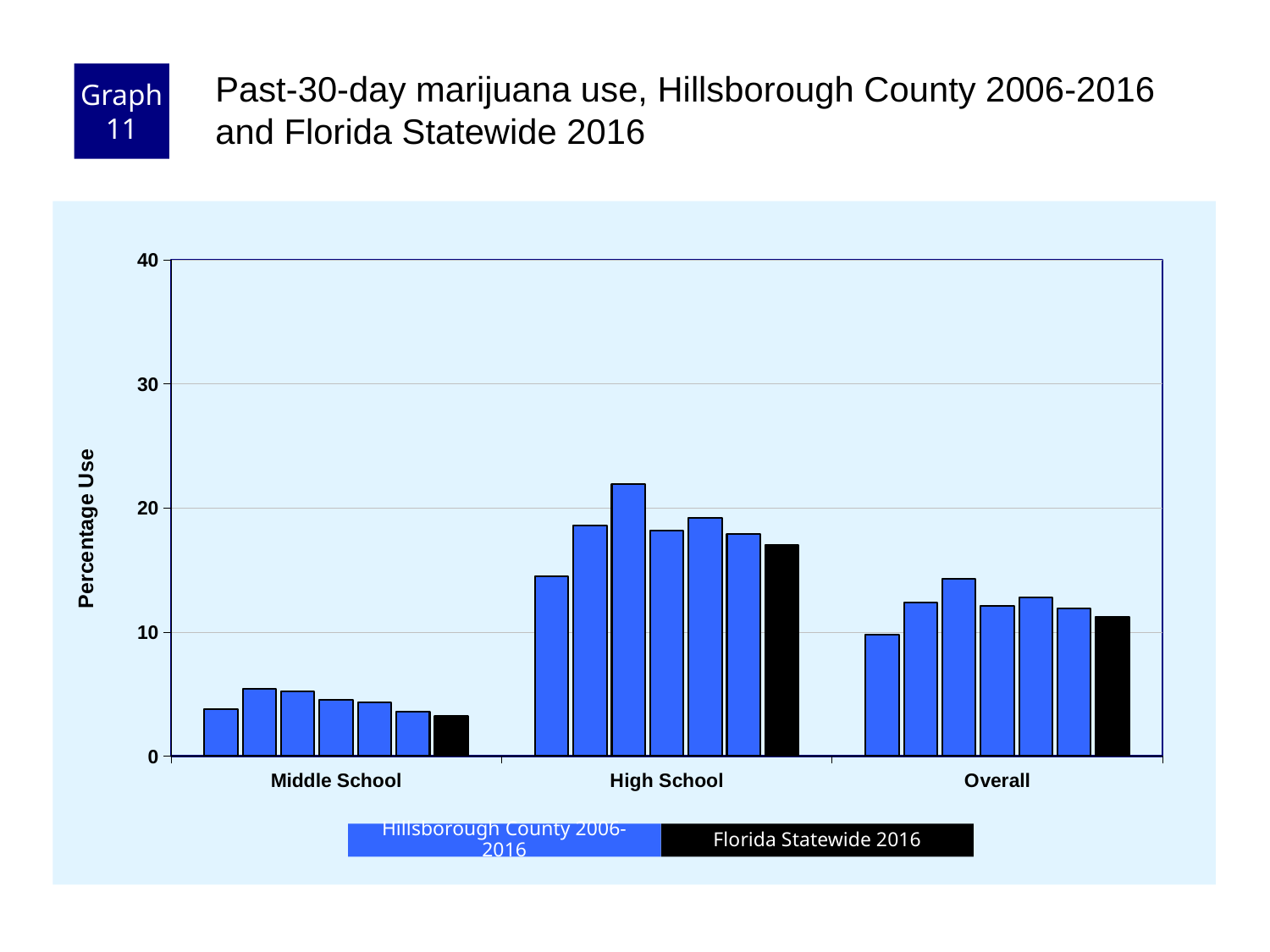
Which is larger, the Florida Statewide 2016 value for High School or for Overall? High School Which category has the highest bars? High School How many categories are shown on the x axis? 3 What kind of chart is shown on the slide? bar chart Which category has the lowest bars? Middle School Is the tallest Hillsborough County bar for High School greater or less than 20? greater Is the Florida Statewide 2016 value for High School greater or less than 20? less What is the label of the y axis? Percentage Use Which series is shown in black? Florida Statewide 2016 Is the Florida Statewide 2016 value for High School greater or less than 10? greater How many series does the legend list? 2